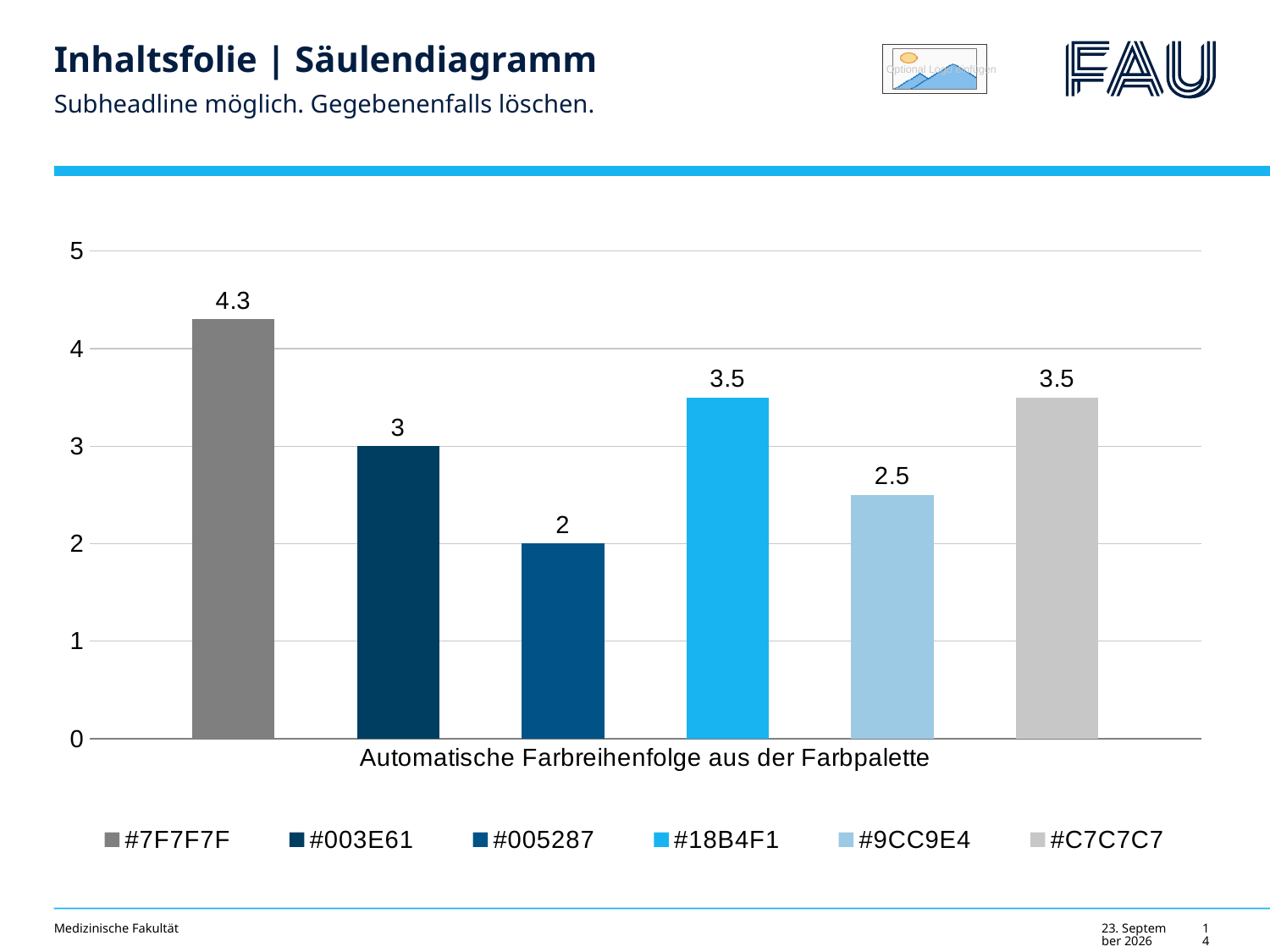
Is the value for #C7C7C7 greater or less than 3? greater How many series does the legend list? 6 What is the value for the #7F7F7F series? 4.3 Which series has the lowest value? #005287 What is the value for the #9CC9E4 series? 2.5 What is the category label shown on the x axis? Automatische Farbreihenfolge aus der Farbpalette What kind of chart is shown on the slide? bar chart Which series has the highest value? #7F7F7F What is the value for the #005287 series? 2 What is the difference between the values for #7F7F7F and #003E61? 1.3 What is the difference between the values for #18B4F1 and #9CC9E4? 1 Which is larger, the value for #003E61 or the value for #9CC9E4? #003E61